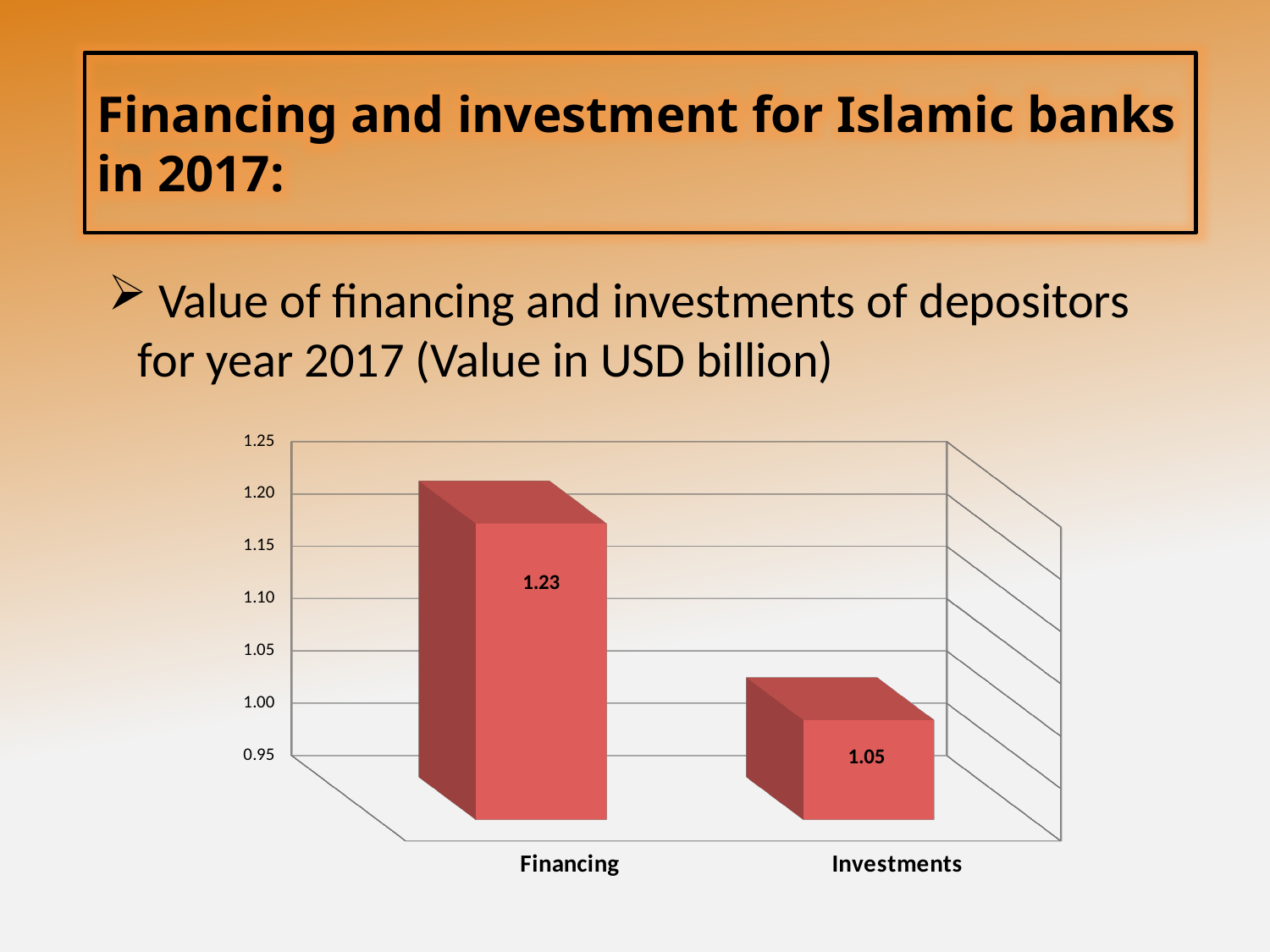
Which category has the lowest value? Investments Which category has the highest value? Financing What is the difference between the values for Financing and Investments? 0.18 What kind of chart is shown on the slide? bar chart What is the value for Investments? 1.05 Is the value for Investments greater or less than 1.10? less What is the value for Financing? 1.23 Do the values rise or fall from Financing to Investments? fall Is the value for Financing greater or less than 1.15? greater What is the lowest value shown on the vertical axis? 0.95 How many categories are shown on the chart? 2 Which is larger, the value for Financing or the value for Investments? Financing